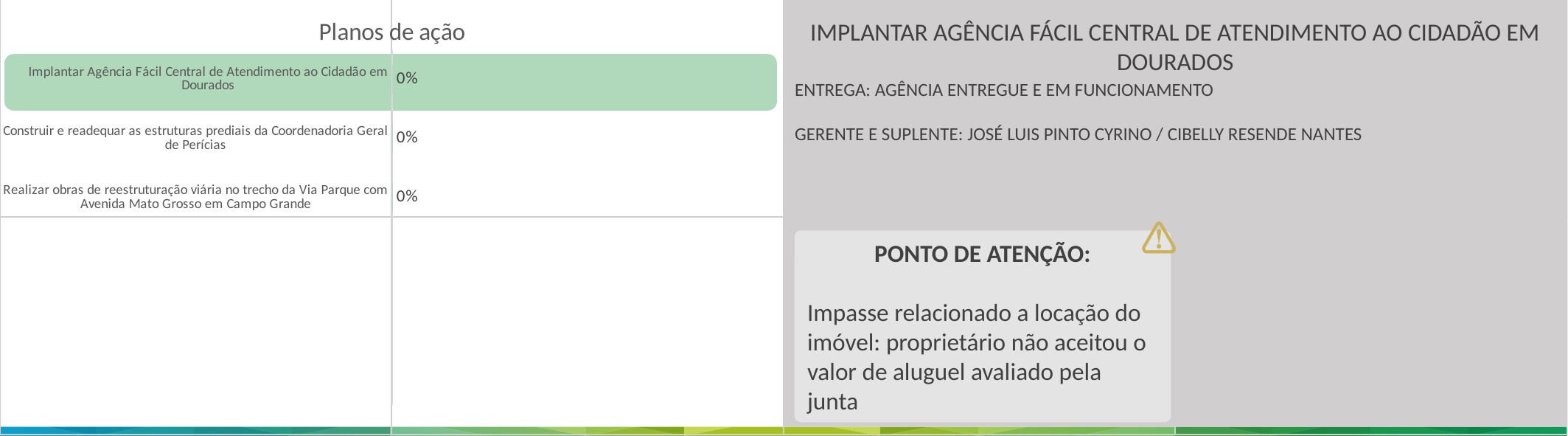
In the "Planos de ação" chart, do all three categories show the same value? Yes, 0% In the "Planos de ação" chart, what is the value for "Implantar Agência Fácil Central de Atendimento ao Cidadão em Dourados"? 0% What is the title of the chart on the left of the slide? Planos de ação In the "Planos de ação" chart, what is the value for "Realizar obras de reestruturação viária no trecho da Via Parque com Avenida Mato Grosso em Campo Grande"? 0% In the "Planos de ação" chart, what is the difference between the value for "Implantar Agência Fácil Central de Atendimento ao Cidadão em Dourados" and the value for "Construir e readequar as estruturas prediais da Coordenadoria Geral de Perícias"? 0% How many categories (action plans) are listed in the "Planos de ação" chart? 3 In the "Planos de ação" chart, what is the value for "Construir e readequar as estruturas prediais da Coordenadoria Geral de Perícias"? 0% What kind of chart is shown under the title "Planos de ação"? bar chart In the "Planos de ação" chart, which category row is highlighted in green? Implantar Agência Fácil Central de Atendimento ao Cidadão em Dourados